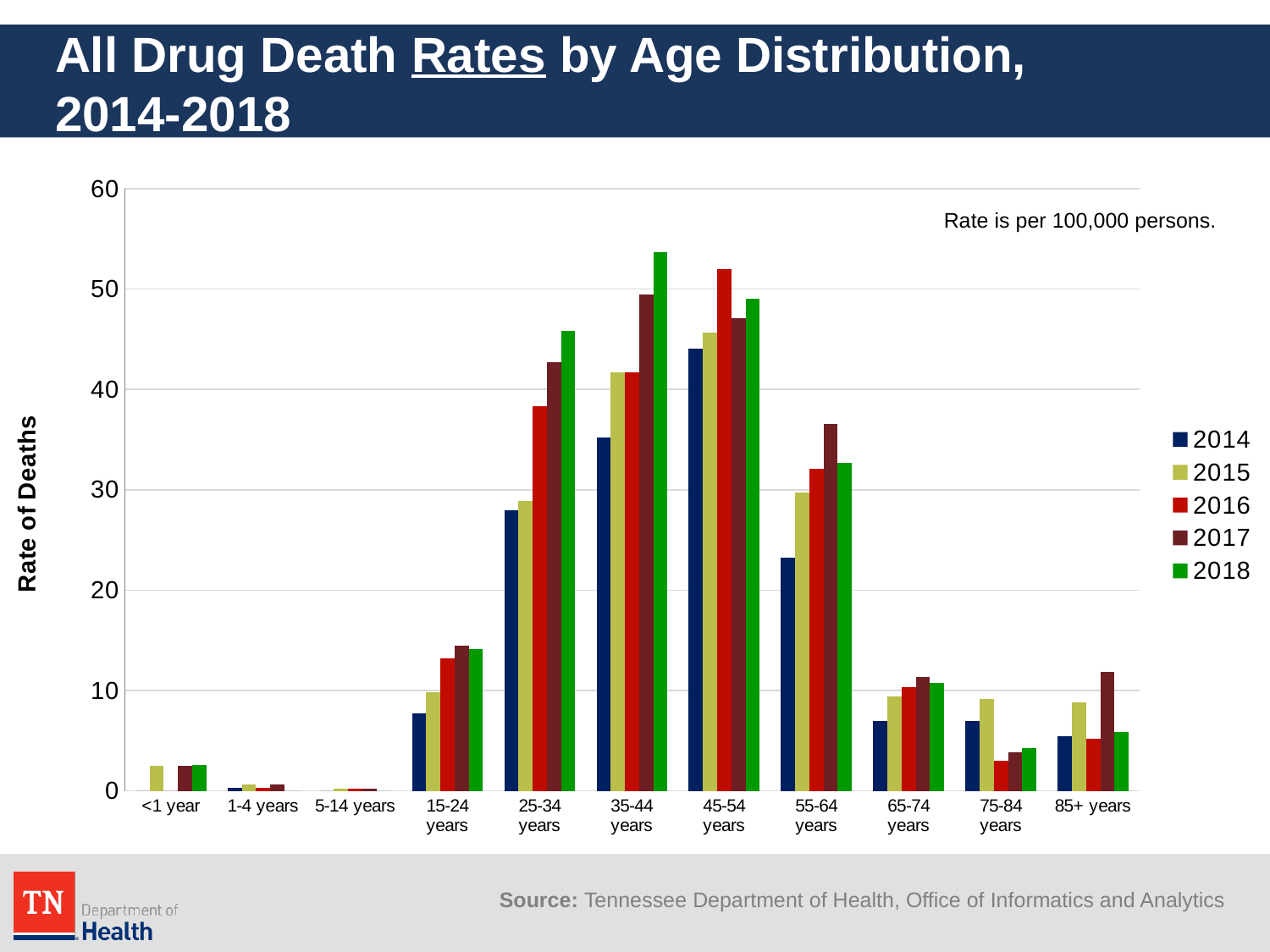
Which age group has the lowest rates across all years? 5-14 years Which age group has the highest rate for 2018? 35-44 years For the 25-34 years group, which is larger: the 2014 value or the 2018 value? 2018 What is the title of the y axis? Rate of Deaths How many age groups are shown on the x axis? 11 Is the 2014 value for 45-54 years greater or less than 40? greater How many series does the legend list? 5 Is the 2014 value for 55-64 years greater or less than 20? greater Is the 2018 value for 35-44 years greater or less than 50? greater What kind of chart is shown on the slide? Bar chart For the 25-34 years group, do the rates rise or fall from 2014 to 2018? rise Which age group has the highest rate for 2016? 45-54 years